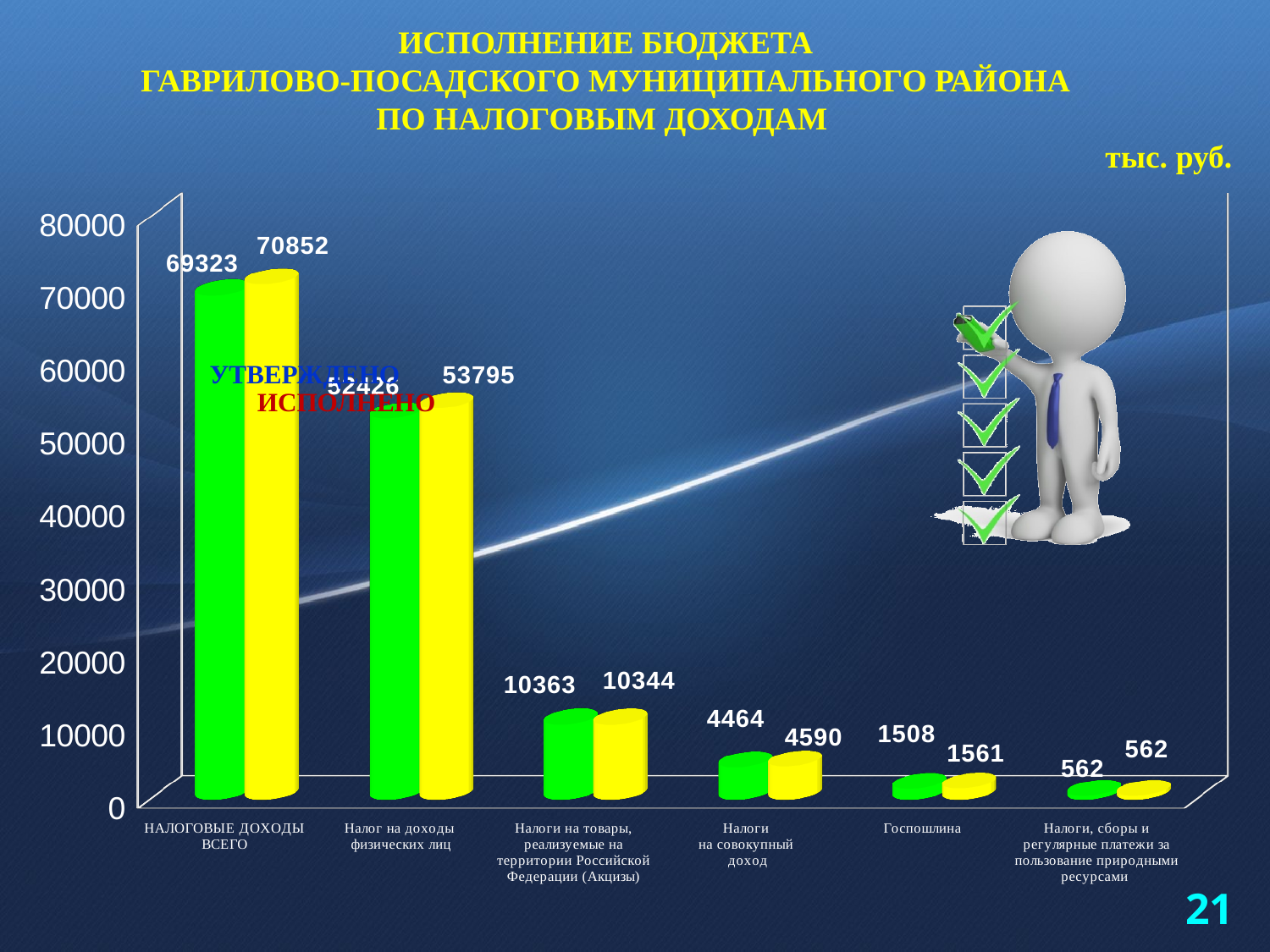
Which is larger for Налоги на совокупный доход: the approved value or the executed value? the executed value (4590) How many categories are shown on the x axis? 6 What is the executed (ИСПОЛНЕНО) value for Налог на доходы физических лиц? 53795 Which category has the lowest executed (ИСПОЛНЕНО) value? Налоги, сборы и регулярные платежи за пользование природными ресурсами How many series does the chart show? 2 What is the difference between the approved and executed values for Налоги на товары, реализуемые на территории Российской Федерации (Акцизы)? 19 What is the difference between the executed and approved values for НАЛОГОВЫЕ ДОХОДЫ ВСЕГО? 1529 What is the approved (УТВЕРЖДЕНО) value for Налоги на совокупный доход? 4464 What is the approved (УТВЕРЖДЕНО) value for НАЛОГОВЫЕ ДОХОДЫ ВСЕГО? 69323 What is the executed (ИСПОЛНЕНО) value for Госпошлина? 1561 What type of chart is shown on the slide? bar chart Which category has the highest approved (УТВЕРЖДЕНО) value? НАЛОГОВЫЕ ДОХОДЫ ВСЕГО